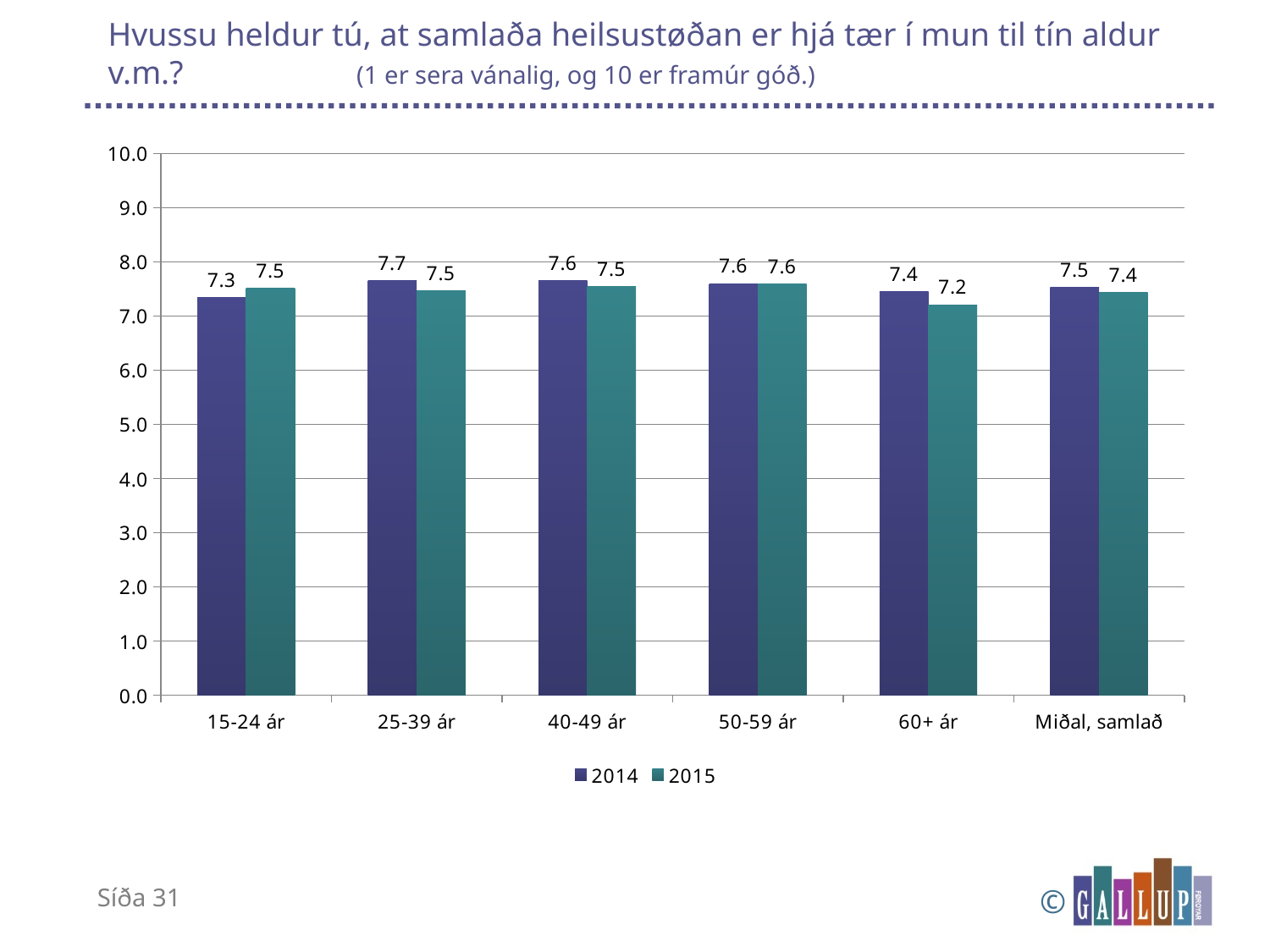
What kind of chart is shown on the slide? bar chart Which category has the lowest value for the 2014 series? 15-24 ár Which category has the lowest value for the 2015 series? 60+ ár What is the value for 2015 in the 60+ ár category? 7.2 Is the 2015 value for 60+ ár greater or less than 8.0? less What is the difference between the 2014 and 2015 values for the 60+ ár category? 0.2 How many categories are shown on the x axis? 6 In the 15-24 ár category, which series has the larger value, 2014 or 2015? 2015 How many series does the legend list? 2 What is the value for 2014 in the 15-24 ár category? 7.3 What is the 2015 value for Miðal, samlað? 7.4 Which category has the highest value for the 2014 series? 25-39 ár